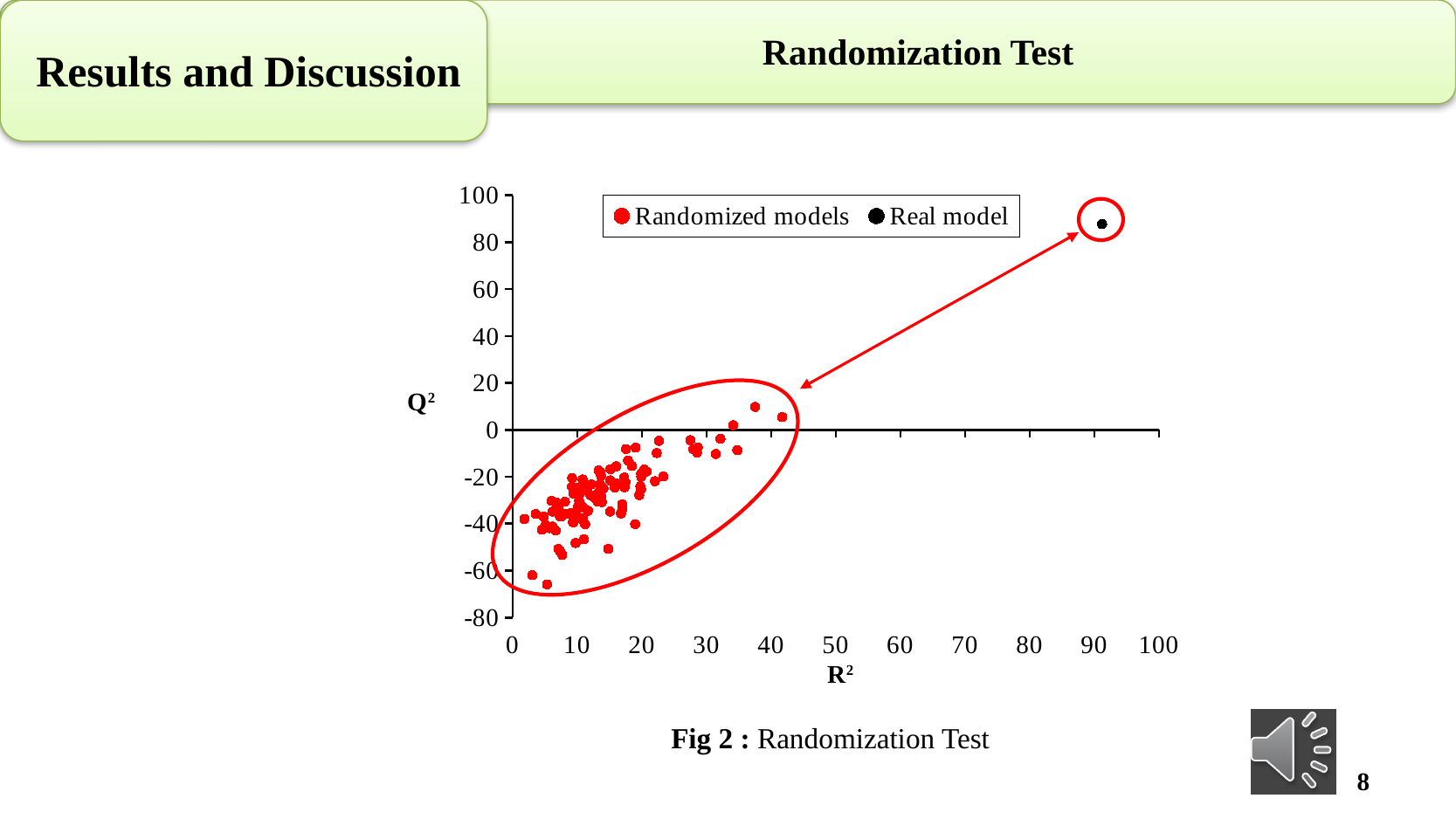
Is the lowest Q² value among the Randomized models greater or less than -60? less Are the Q² values of all the Randomized models points greater or less than 20? less Which series has the higher Q² value, the Real model or the Randomized models? Real model Are the R² values of all the Randomized models points greater or less than 50? less Which series has the higher R² value, the Real model or the Randomized models? Real model Do the Q² values of the Randomized models generally rise or fall as R² increases? rise What kind of chart is shown on the slide? scatter chart What are the two series named in the legend? Randomized models and Real model How many series does the legend list? 2 What is the label of the x axis? R²